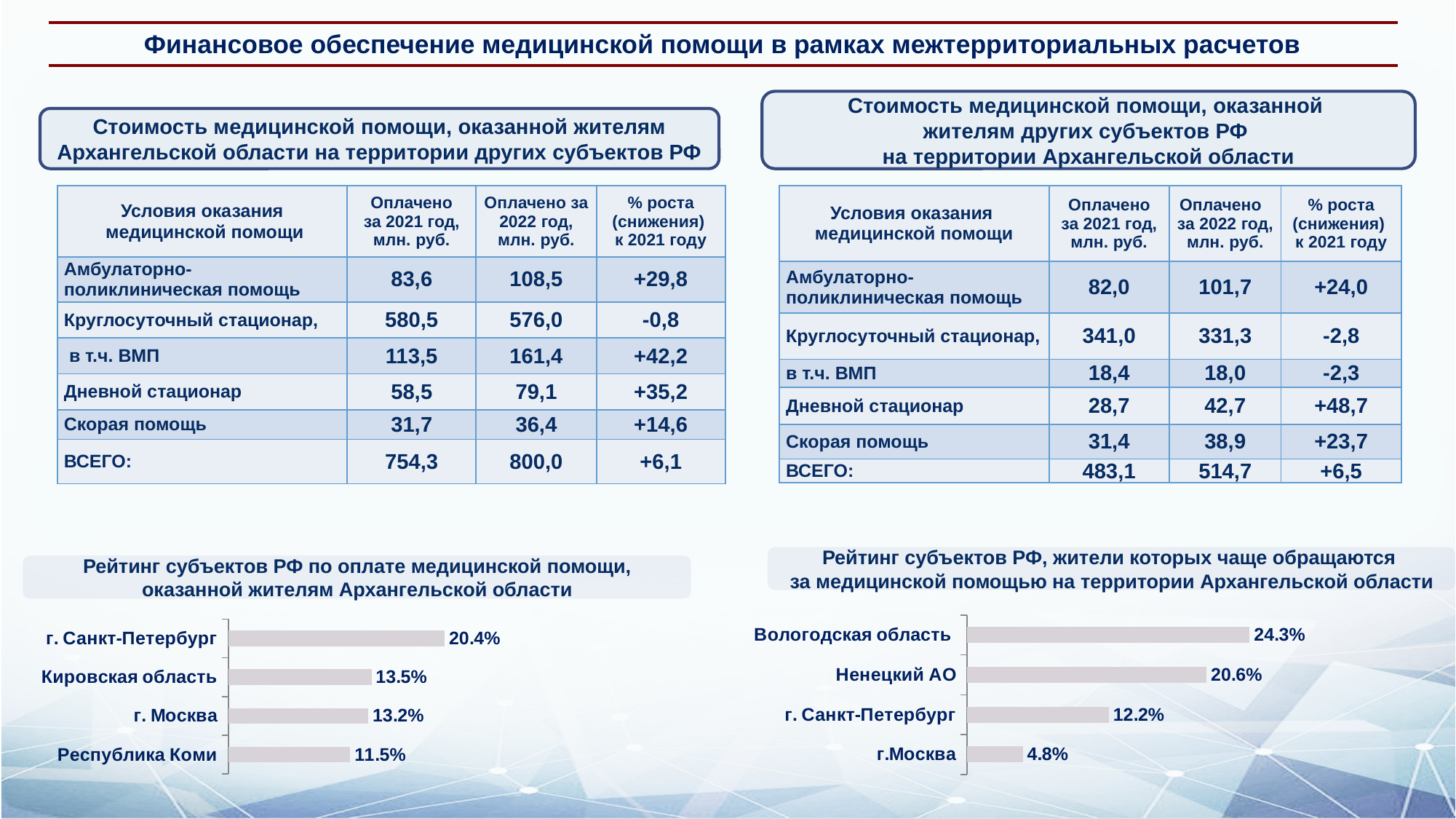
In the bottom-left chart, what is the difference between the values for г. Санкт-Петербург and Кировская область? 6.9% In the bottom-right chart, what is the value for Ненецкий АО? 20.6% In the bottom-left chart, what is the value for г. Санкт-Петербург? 20.4% In the bottom-left chart, which category has the highest value? г. Санкт-Петербург In the bottom-left chart, how many categories are shown? 4 What type of chart is the bottom-right chart? Bar chart In the bottom-left chart, which category has the lowest value? Республика Коми In the bottom-right chart, which category has the highest value? Вологодская область In the bottom-right chart, what is the value for г.Москва? 4.8% In the bottom-right chart, which is larger: the value for г. Санкт-Петербург or the value for г.Москва? г. Санкт-Петербург In the bottom-left chart, what is the value for Республика Коми? 11.5% In the bottom-right chart, what is the difference between the values for Вологодская область and Ненецкий АО? 3.7%